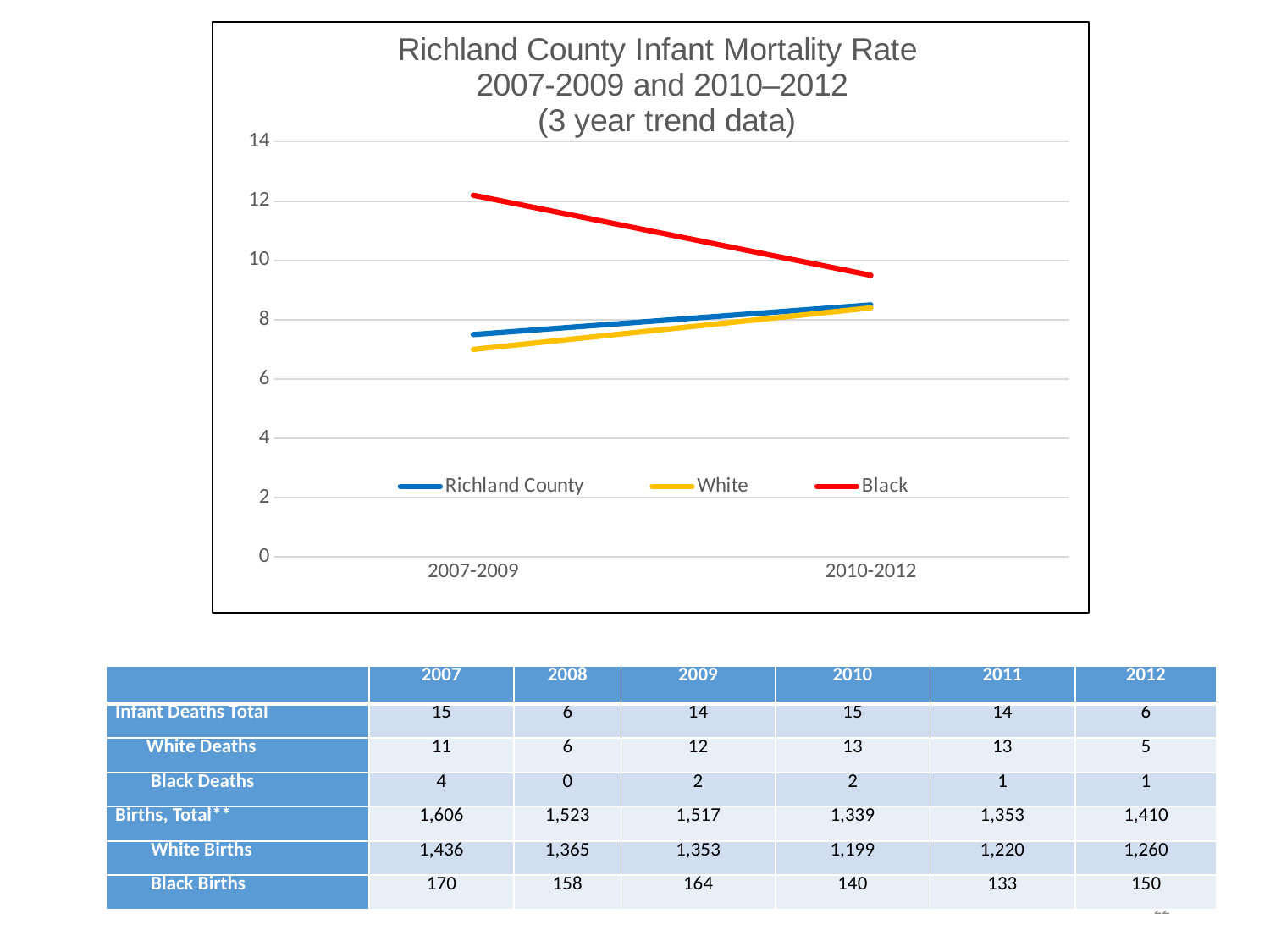
Which series has the highest infant mortality rate in 2007-2009? Black In 2010-2012, which is larger: the Black rate or the White rate? Black Is the Black infant mortality rate for 2007-2009 greater or less than 10? greater Does the White infant mortality rate rise or fall from 2007-2009 to 2010-2012? rise How many series does the chart's legend list? 3 Which colour is used for the Black series in the chart? red Is the Black infant mortality rate for 2010-2012 greater or less than 10? less Does the Black infant mortality rate rise or fall from 2007-2009 to 2010-2012? fall Is the White infant mortality rate for 2007-2009 greater or less than 8? less How many time periods are shown on the x axis of the chart? 2 What kind of chart is shown on the slide? line chart Which series has the lowest infant mortality rate in 2007-2009? White